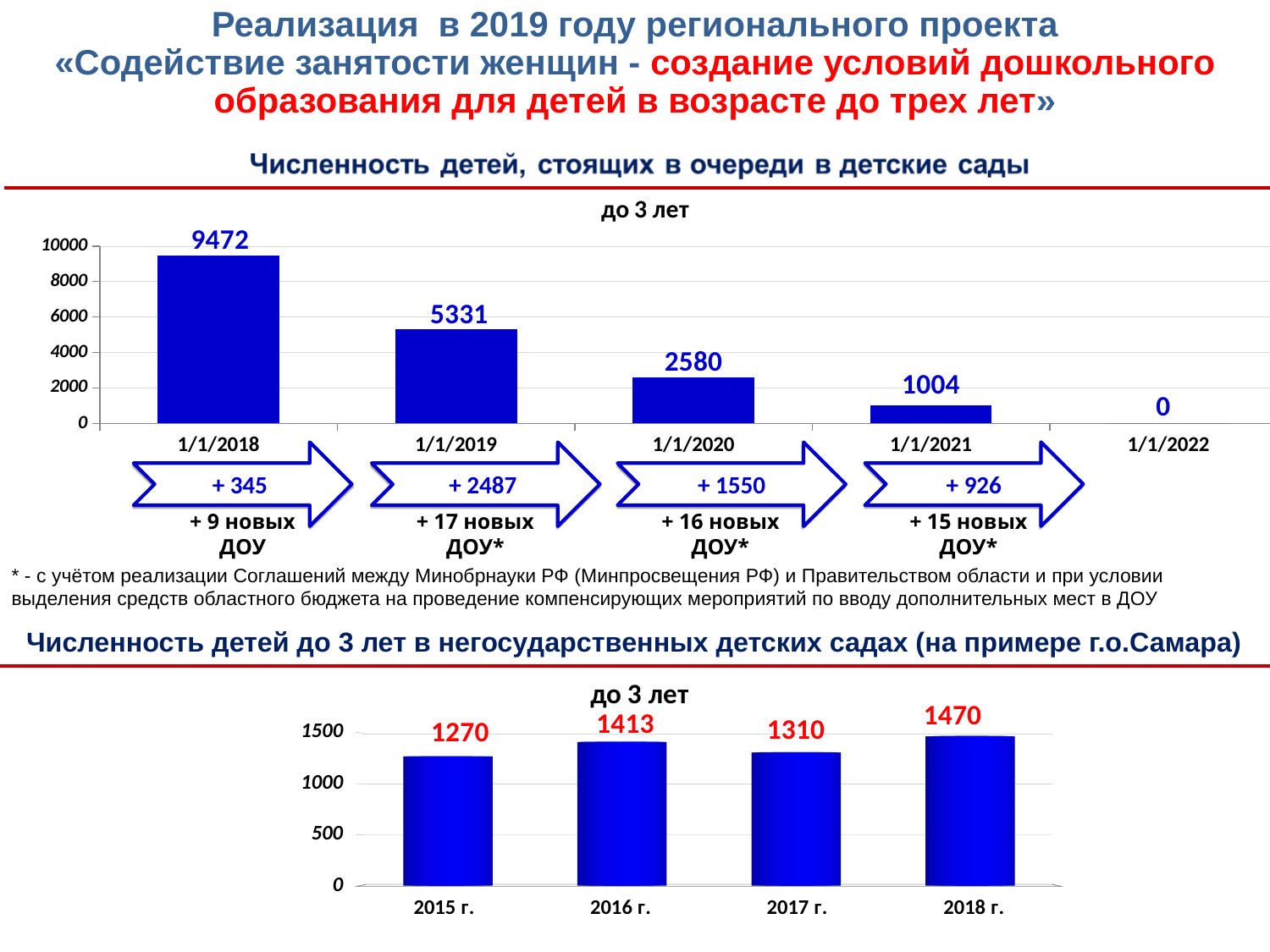
In the top chart (Численность детей, стоящих в очереди в детские сады), do the values rise or fall from 1/1/2018 to 1/1/2022? fall In the top chart (Численность детей, стоящих в очереди в детские сады), what is the value for 1/1/2018? 9472 In the bottom chart (Численность детей до 3 лет в негосударственных детских садах), what is the value for 2016 г.? 1413 In the top chart (Численность детей, стоящих в очереди в детские сады), what is the difference between the values for 1/1/2019 and 1/1/2021? 4327 In the top chart (Численность детей, стоящих в очереди в детские сады), what is the value for 1/1/2020? 2580 In the top chart (Численность детей, стоящих в очереди в детские сады), which date has the highest value? 1/1/2018 What kind of chart is the bottom chart (Численность детей до 3 лет в негосударственных детских садах)? bar chart In the bottom chart (Численность детей до 3 лет в негосударственных детских садах), which year has the highest value? 2018 г. In the bottom chart (Численность детей до 3 лет в негосударственных детских садах), which year has the lowest value? 2015 г. In the bottom chart (Численность детей до 3 лет в негосударственных детских садах), what is the difference between the values for 2018 г. and 2015 г.? 200 In the top chart (Численность детей, стоящих в очереди в детские сады), how many dates are shown on the x axis? 5 In the bottom chart (Численность детей до 3 лет в негосударственных детских садах), which is larger, the value for 2016 г. or 2017 г.? 2016 г.